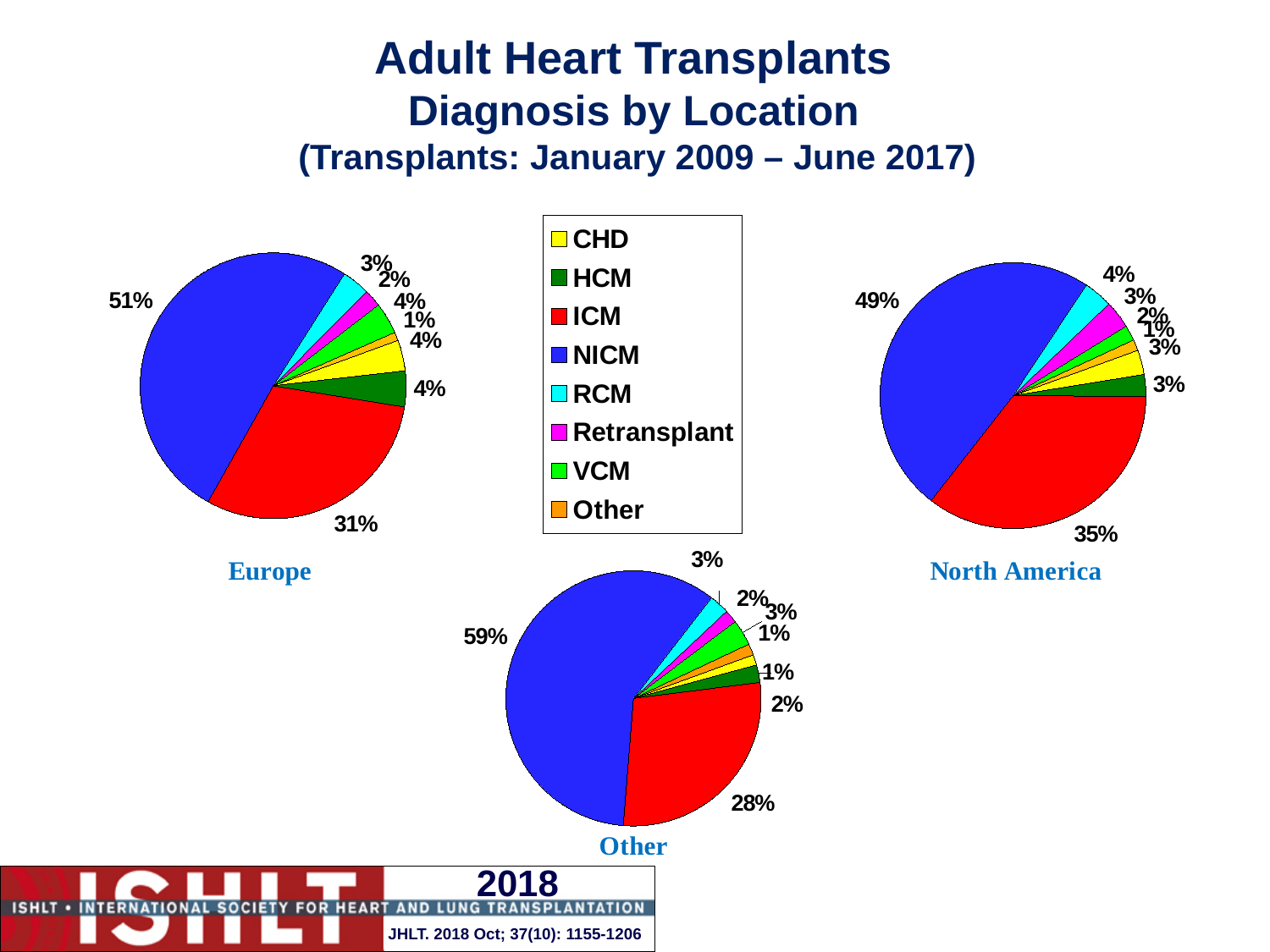
In the North America pie chart, what share of adult heart transplants is ICM? 35% In the Other pie chart, what share of adult heart transplants is NICM? 59% In the Europe pie chart, what share of adult heart transplants is ICM? 31% How many diagnosis categories does the legend list? 8 What kind of chart is used to show diagnosis by location on this slide? Pie chart Which is larger: the NICM share in the Other pie chart or the NICM share in the Europe pie chart? Other How many pie charts are shown on the slide? 3 In the Europe pie chart, what share of adult heart transplants is NICM? 51% In the North America pie chart, what is the difference between the NICM share and the ICM share? 14% In the Europe pie chart, what is the difference between the NICM share and the ICM share? 20% In the Other pie chart, what share of adult heart transplants is ICM? 28% In the North America pie chart, which diagnosis has the largest share? NICM